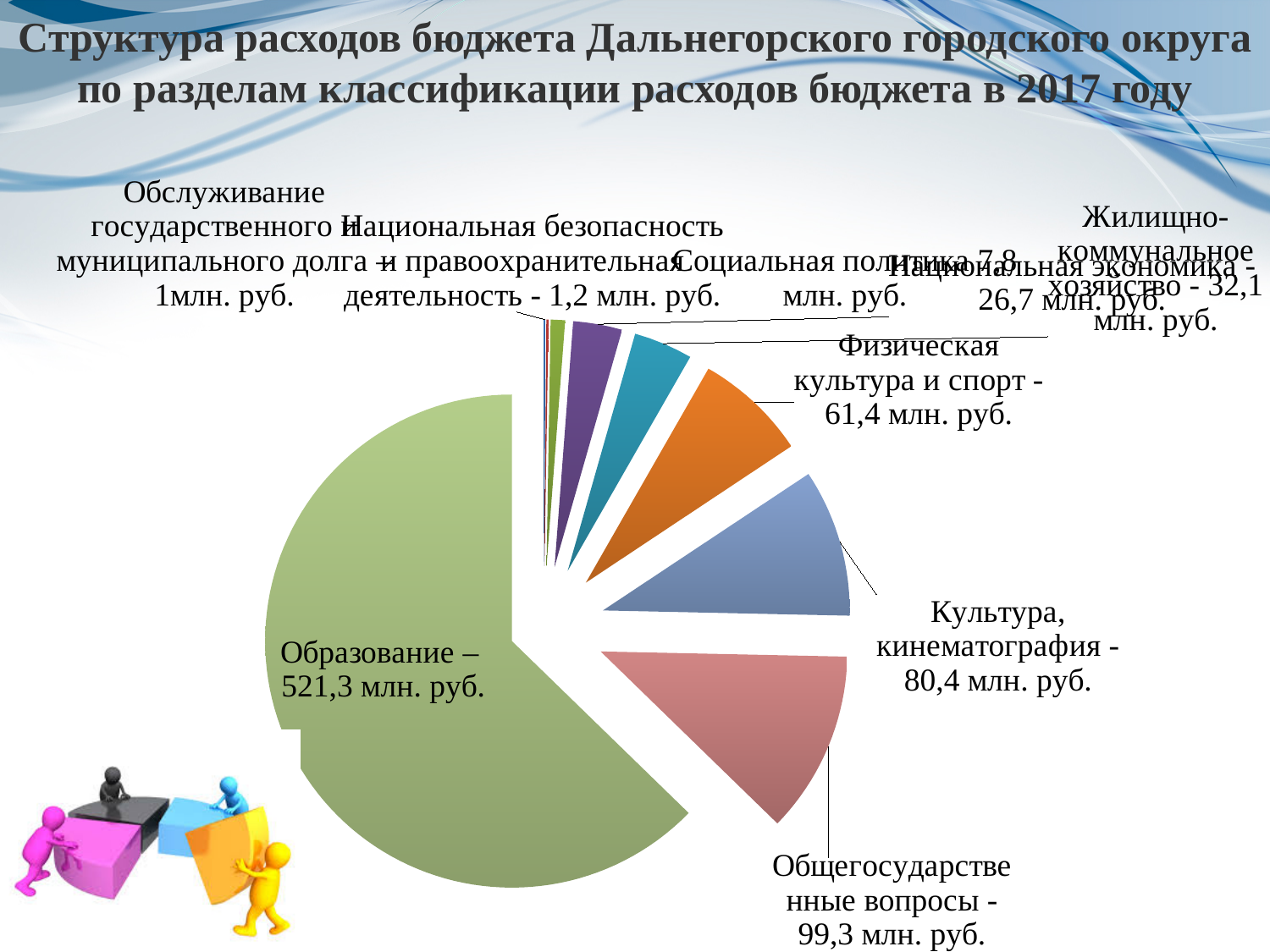
What is the value for Общегосударственные вопросы? 99,3 млн. руб. What is the value for Физическая культура и спорт? 61,4 млн. руб. What is the value for Культура, кинематография? 80,4 млн. руб. What kind of chart is shown on the slide? Pie chart What is the value for Жилищно-коммунальное хозяйство? 32,1 млн. руб. Which is larger: Жилищно-коммунальное хозяйство or Национальная экономика? Жилищно-коммунальное хозяйство What is the value for Образование? 521,3 млн. руб. Which year does the chart's title refer to? 2017 How many sections (slices) does the pie chart show? 9 Which section has the smallest value? Обслуживание государственного и муниципального долга Which section has the largest share of budget expenditures? Образование What is the difference between Общегосударственные вопросы and Культура, кинематография? 18,9 млн. руб.